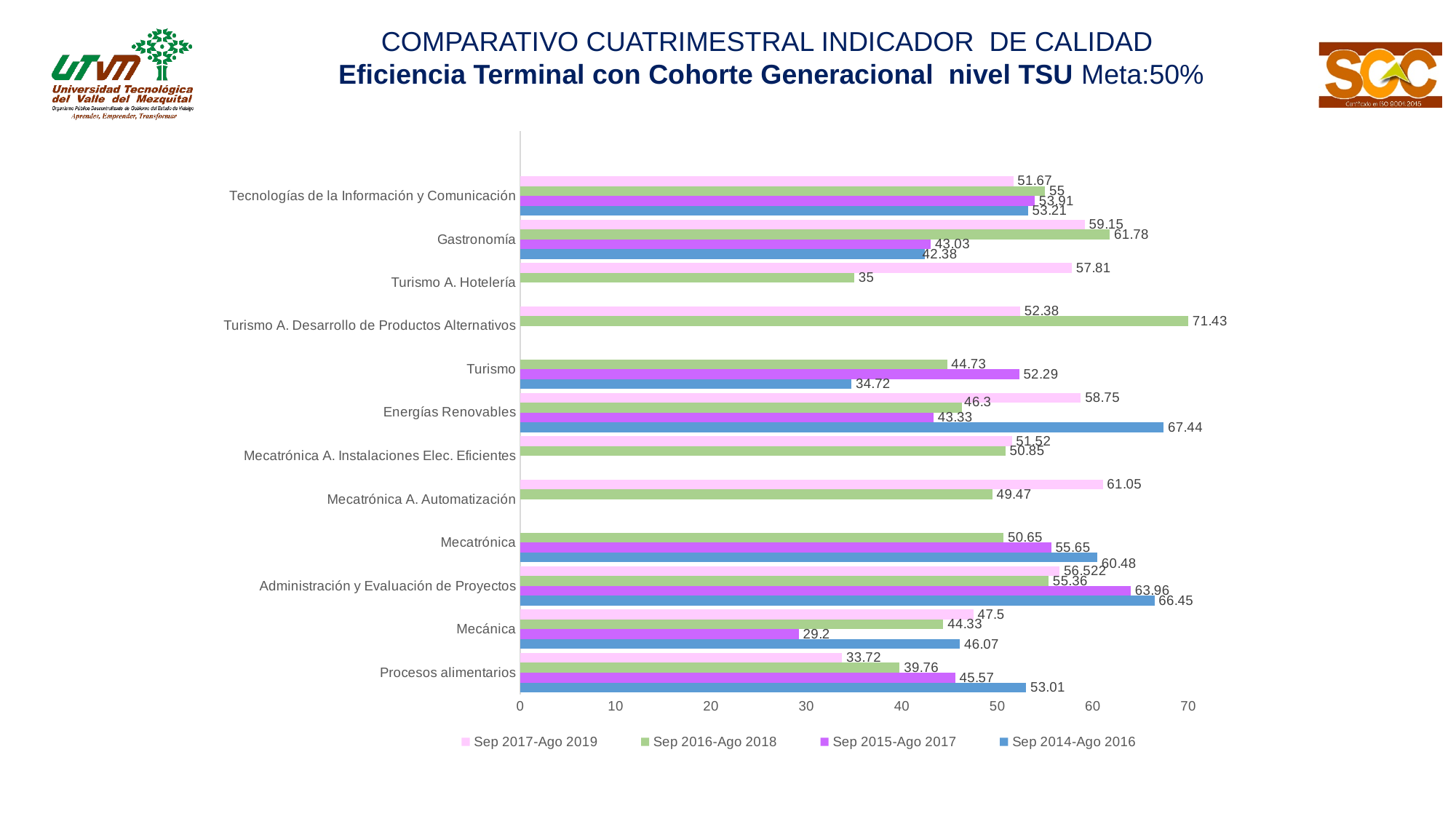
What is the value for Turismo A. Hotelería in the Sep 2016-Ago 2018 series? 35 For Procesos alimentarios, which series has the larger value: Sep 2014-Ago 2016 or Sep 2017-Ago 2019? Sep 2014-Ago 2016 How many categories (programs) are shown on the y axis of the chart? 12 Which category has the lowest value in the Sep 2015-Ago 2017 series? Mecánica What is the difference between the Sep 2017-Ago 2019 and Sep 2015-Ago 2017 values for Mecánica? 18.3 What is the difference between the Sep 2017-Ago 2019 and Sep 2014-Ago 2016 values for Gastronomía? 16.77 What is the value for Gastronomía in the Sep 2016-Ago 2018 series? 61.78 What is the value for Energías Renovables in the Sep 2014-Ago 2016 series? 67.44 What kind of chart is shown on the slide? Bar chart What is the value for Administración y Evaluación de Proyectos in the Sep 2017-Ago 2019 series? 56.522 How many series does the legend list? 4 Which category has the highest value in the Sep 2016-Ago 2018 series? Turismo A. Desarrollo de Productos Alternativos